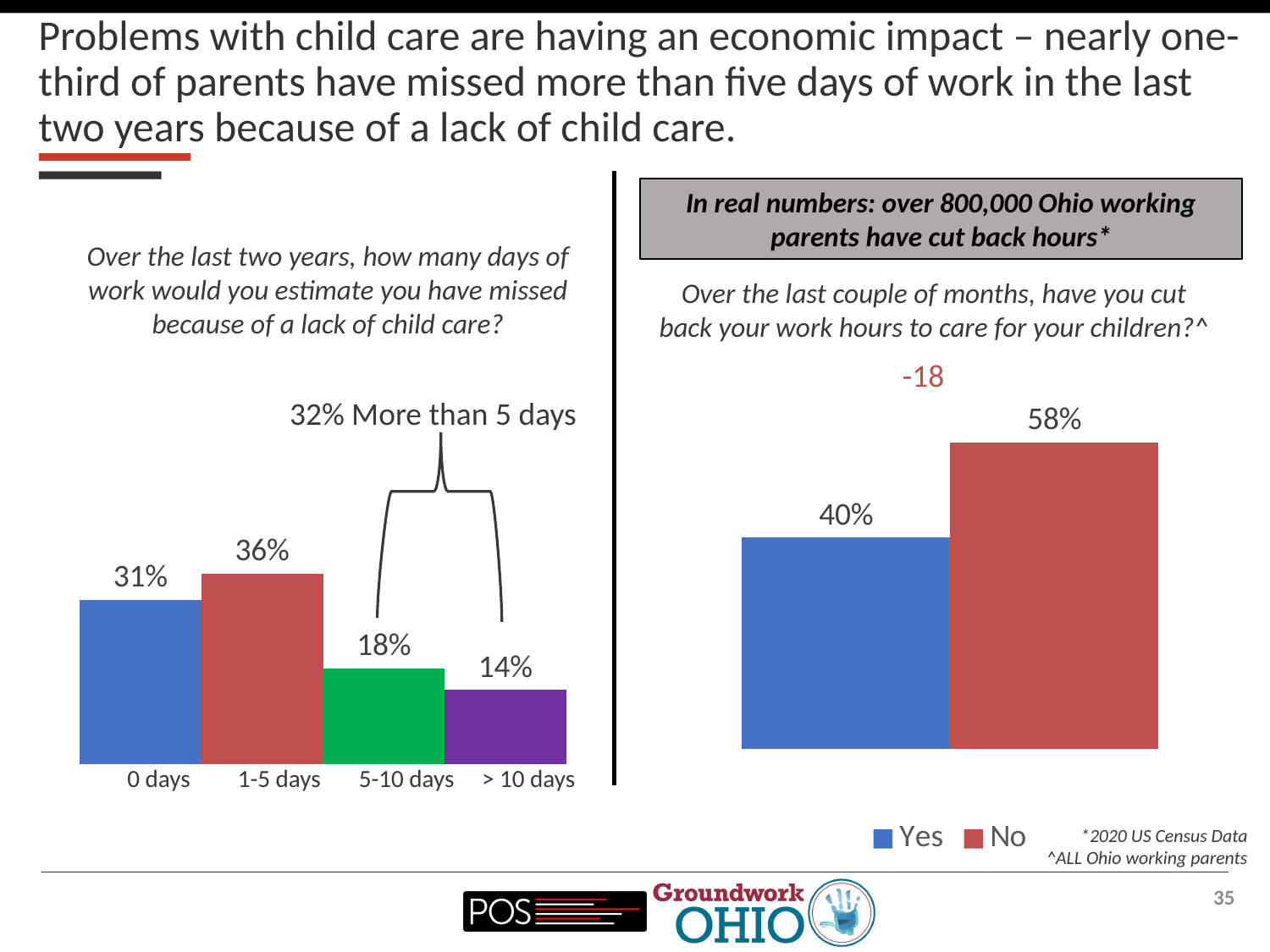
On the left chart about days of work missed, what combined percentage is labelled as 'More than 5 days'? 32% On the left chart about days of work missed, which category has the highest value? 1-5 days On the left chart about days of work missed, which category has the lowest value? > 10 days On the right chart about cutting back work hours, what percentage answered No? 58% On the left chart about days of work missed, how many categories are shown? 4 On the left chart about days of work missed, what is the difference between the 1-5 days value and the 5-10 days value? 18% On the left chart about days of work missed, what percentage of parents said > 10 days? 14% On the right chart about cutting back work hours, which is larger, Yes or No? No On the right chart about cutting back work hours, what percentage answered Yes? 40% On the left chart about days of work missed, what percentage of parents said 0 days? 31% On the right chart about cutting back work hours, how many series does the legend list? 2 On the left chart about days of work missed, what percentage of parents said 1-5 days? 36%